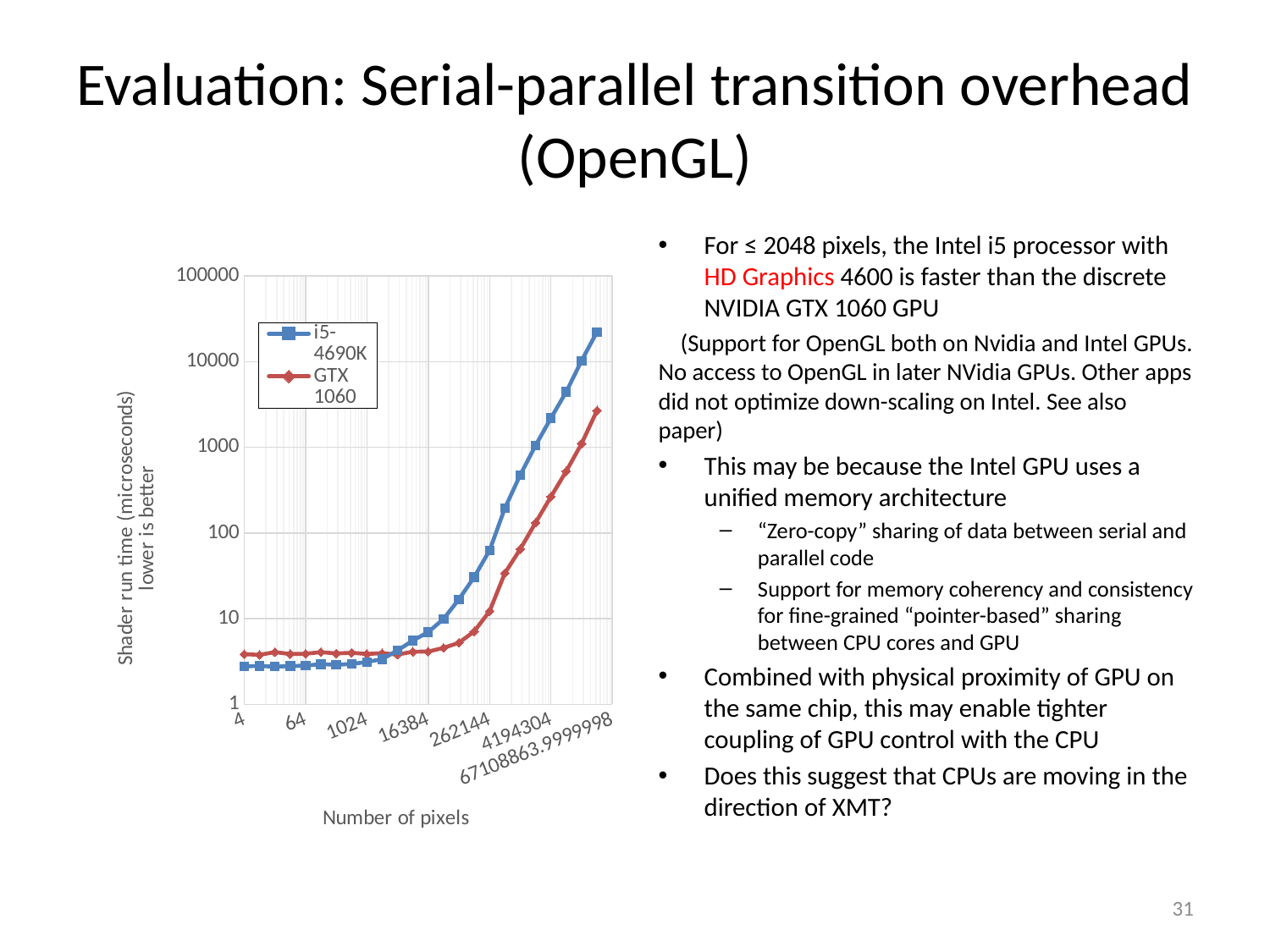
At 4 pixels, which series has the higher shader run time, i5-4690K or GTX 1060? GTX 1060 What are the two series named in the chart's legend? i5-4690K and GTX 1060 At the largest number of pixels on the x axis, which series has the higher shader run time, i5-4690K or GTX 1060? i5-4690K How many series does the chart's legend list? 2 Do the i5-4690K values rise or fall overall as the number of pixels increases? rise Is the GTX 1060 value at 4 pixels greater or less than 10? less Is the GTX 1060 value at the rightmost point of the chart greater or less than 10000? less What kind of chart is shown on the slide? line chart What is the title of the chart's x axis? Number of pixels Which series reaches the highest shader run time anywhere on the chart? i5-4690K Is the i5-4690K value at the rightmost point of the chart greater or less than 10000? greater